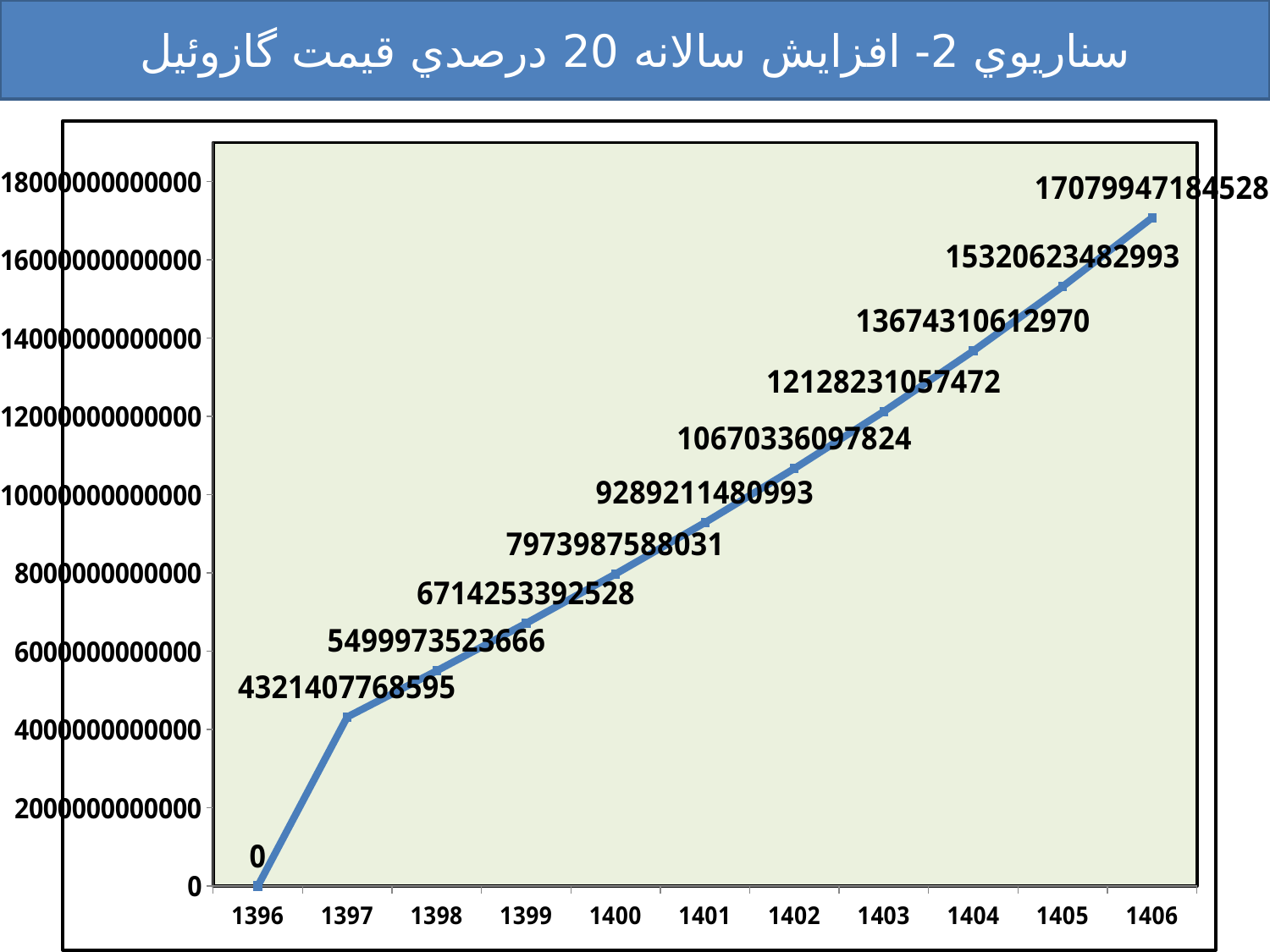
Which is larger, the value for 1402 or the value for 1403? 1403 What kind of chart is shown? line chart Which year has the highest value? 1406 What is the difference between the values for 1406 and 1405? 1759323701535 How many years are plotted on the x axis? 11 What is the value for 1406? 17079947184528 What is the value for 1401? 9289211480993 Do the values rise or fall from 1396 to 1406? rise What is the value for 1397? 4321407768595 What is the value for 1396? 0 Which year has the lowest value? 1396 Is the value for 1400 greater or less than 8000000000000? less